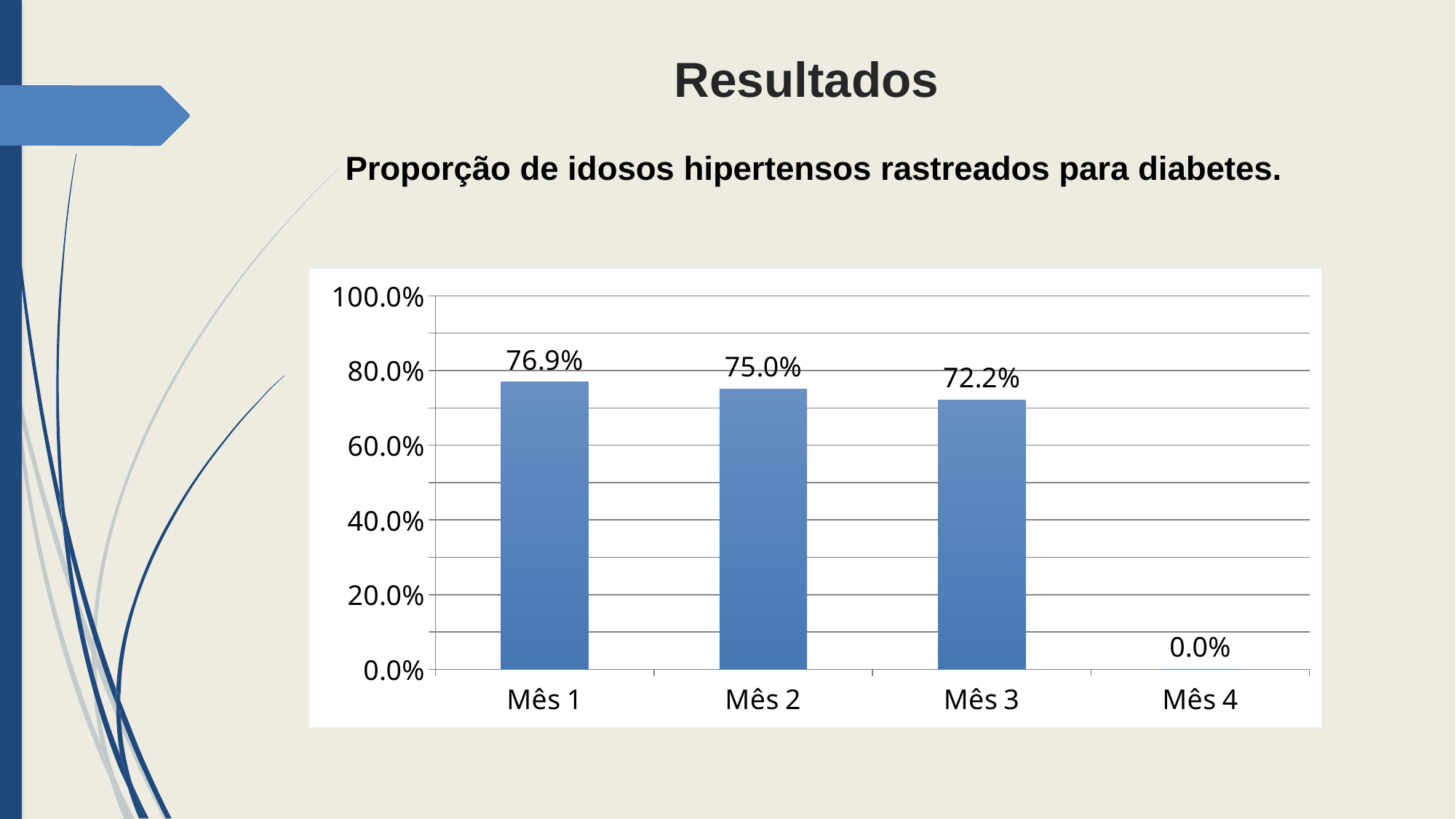
Do the values rise or fall from Mês 1 to Mês 4? fall What is the value for Mês 1? 76.9% What is the value for Mês 2? 75.0% What is the value for Mês 4? 0.0% Which month has the lowest value? Mês 4 Which month has the highest value? Mês 1 Which is larger, the value for Mês 2 or the value for Mês 3? Mês 2 What is the difference between the values for Mês 1 and Mês 3? 4.7% What is the value for Mês 3? 72.2% How many months are shown on the x axis? 4 Is the value for Mês 1 greater or less than 80.0%? less What kind of chart is shown on the slide? bar chart